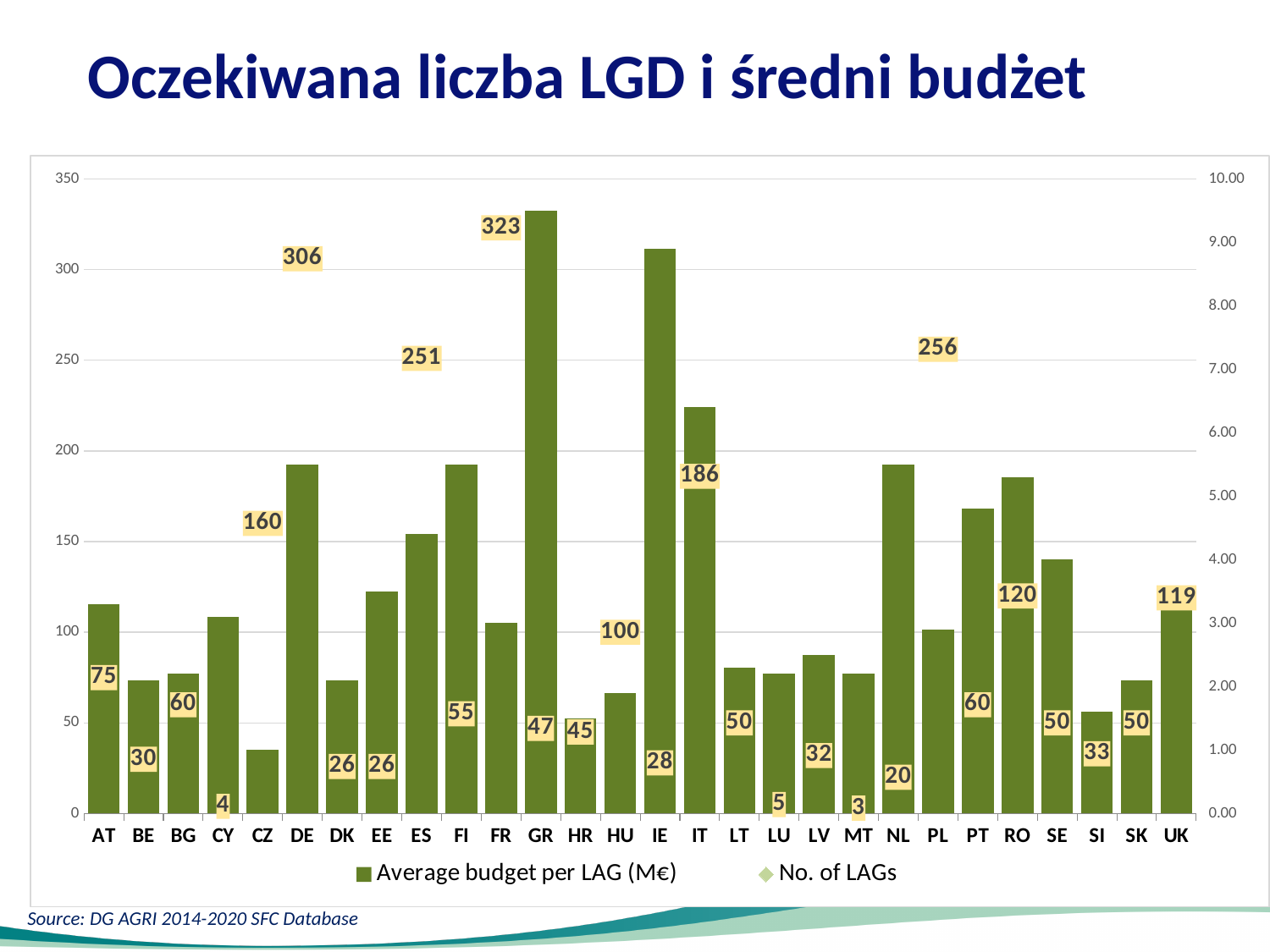
What is the difference between the No. of LAGs for FR and DE? 17 Which has a larger No. of LAGs, ES or PL? PL Which country has the lowest No. of LAGs? MT What is the No. of LAGs value shown for FR? 323 What kind of chart is used to show the Average budget per LAG? bar chart What is the No. of LAGs value shown for DE? 306 How many series does the legend list? 2 Is the Average budget per LAG bar for GR greater or less than 9.00 on the right-hand axis? greater How many countries are shown on the x axis? 28 What is the title of the slide? Oczekiwana liczba LGD i średni budżet What is the No. of LAGs value shown for CY? 4 Which country has the highest No. of LAGs? FR